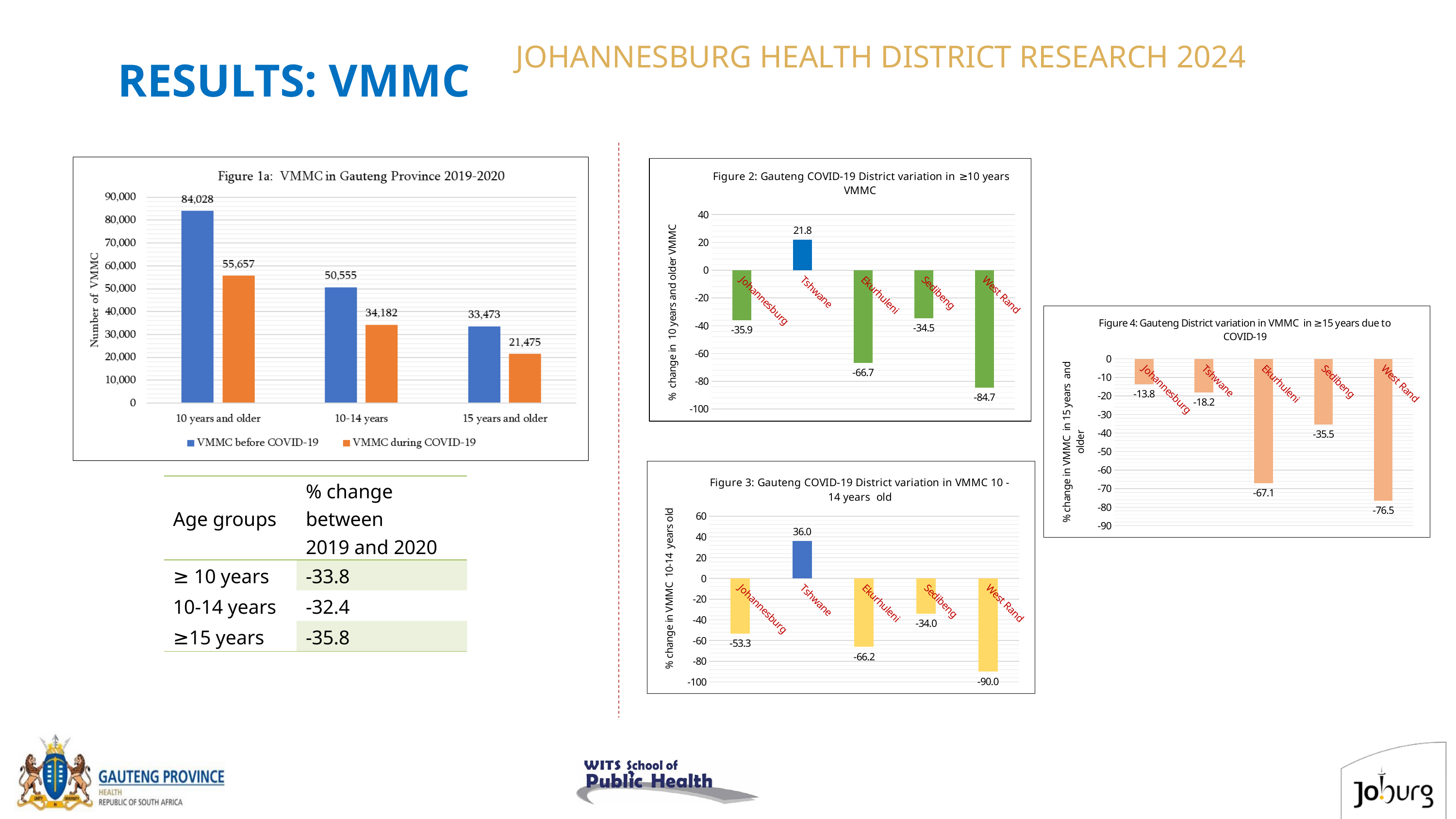
In Figure 3, what is the % change for Johannesburg? -53.3 In Figure 3, how many districts are shown? 5 In Figure 1a, which age group has the lowest VMMC during COVID-19? 15 years and older In Figure 2, which district has the lowest % change? West Rand In Figure 2, which district has the highest % change in 10 years and older VMMC? Tshwane In Figure 4, which is larger, the % change for Johannesburg or for Tshwane? Johannesburg In Figure 2, what is the % change for Ekurhuleni? -66.7 In Figure 1a, what is the value of VMMC before COVID-19 for 10 years and older? 84,028 In Figure 1a, what is the difference between VMMC before COVID-19 and VMMC during COVID-19 for 10-14 years? 16,373 In Figure 1a, how many series does the legend list? 2 In Figure 1a, what is the value of VMMC during COVID-19 for 15 years and older? 21,475 In Figure 4, what is the % change for Sedibeng? -35.5